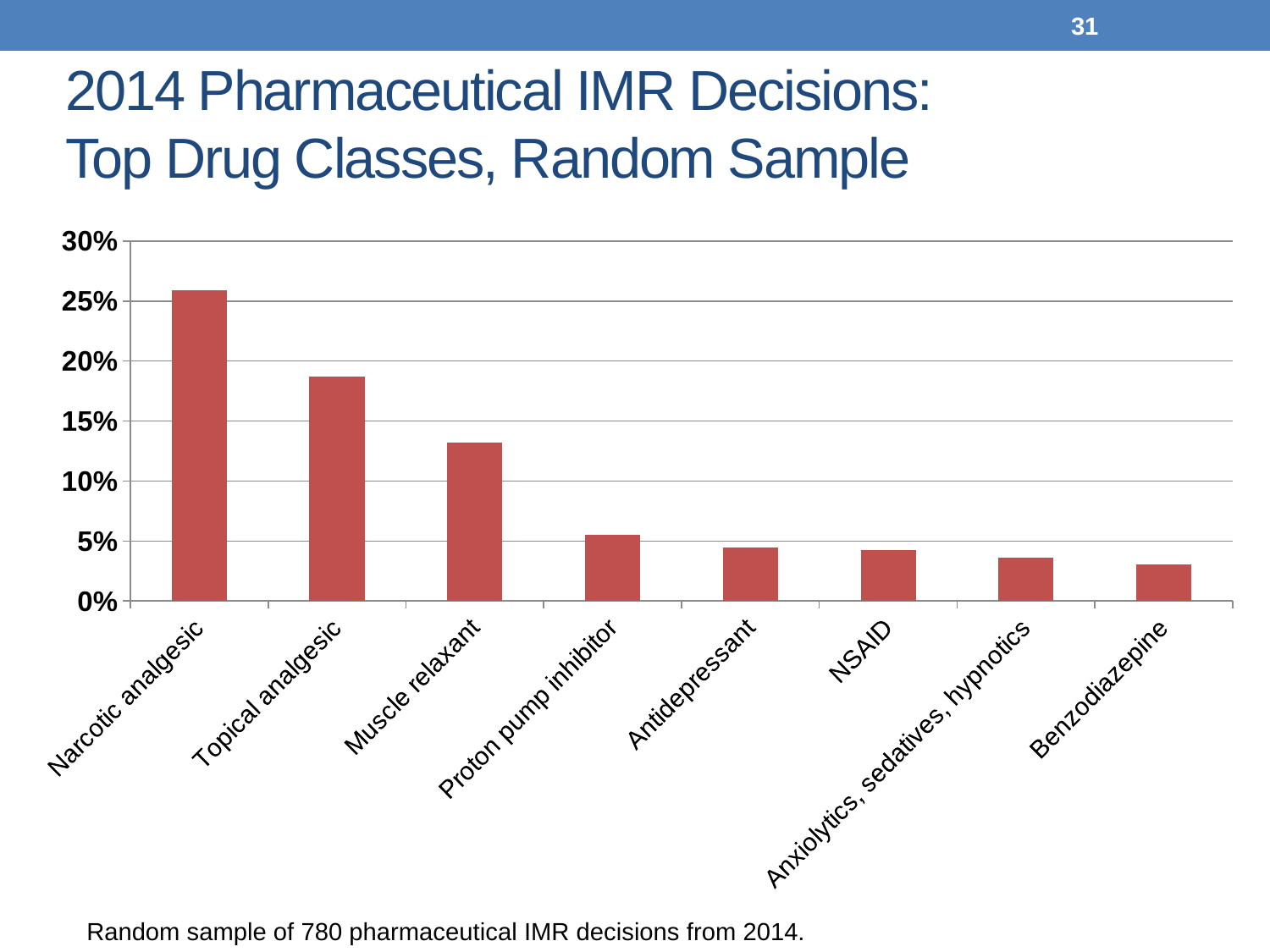
According to the note below the chart, how many pharmaceutical IMR decisions were in the random sample? 780 How many drug classes are shown on the x axis of the chart? 8 Which drug class has the highest percentage in the chart? Narcotic analgesic What kind of chart is shown on the slide? bar chart Is the value for Topical analgesic greater or less than 20%? less Is the value for Muscle relaxant greater or less than 10%? greater Is the value for Narcotic analgesic greater or less than 25%? greater Which drug class has the lowest percentage in the chart? Benzodiazepine Do the values rise or fall moving from left to right along the x axis? fall Which is larger, the value for Topical analgesic or the value for Muscle relaxant? Topical analgesic